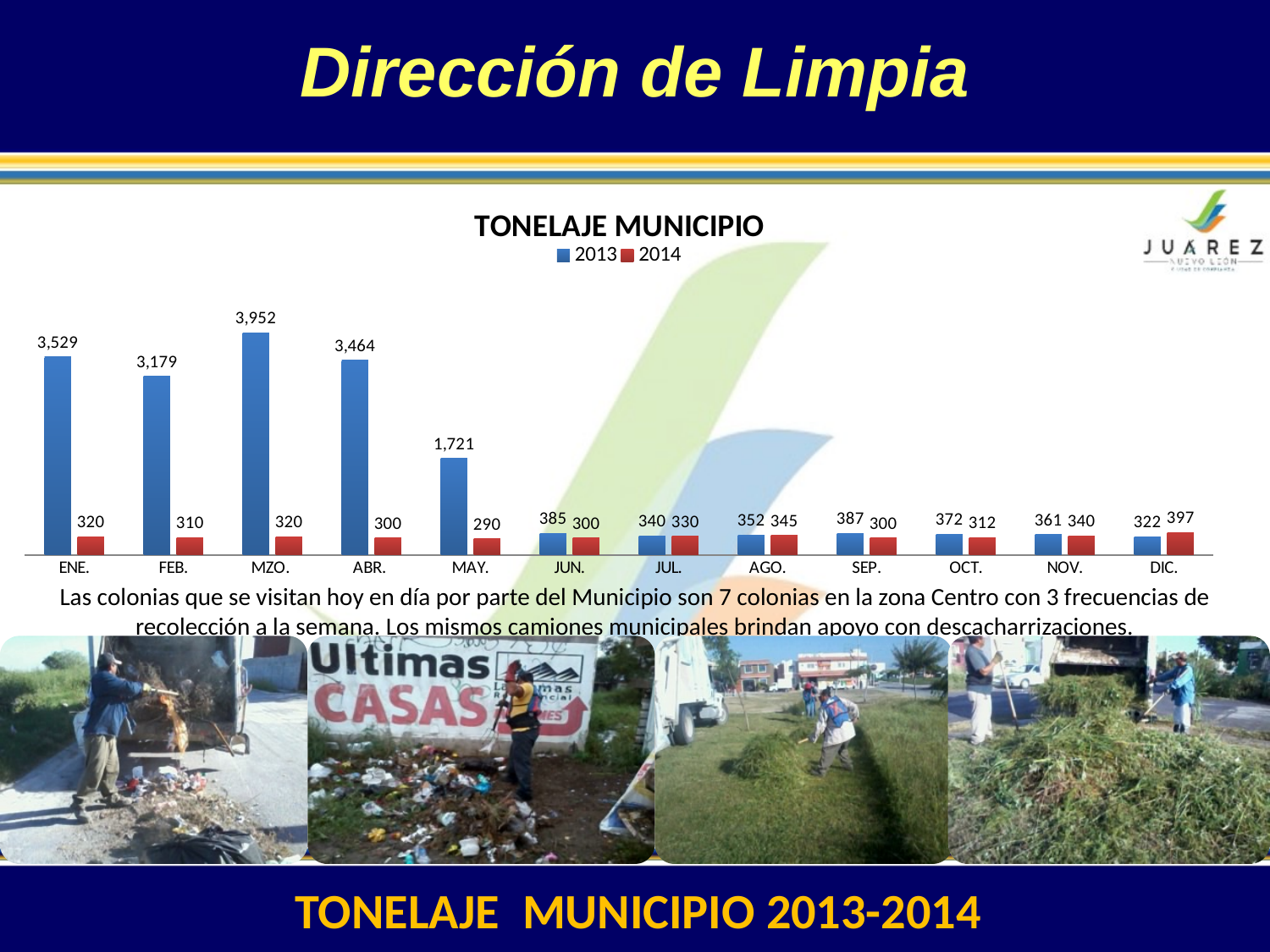
What is the difference between the 2013 and 2014 values for ENE. in the TONELAJE MUNICIPIO chart? 3,209 Which colour represents the 2014 series in the TONELAJE MUNICIPIO chart? Red How many series does the legend of the TONELAJE MUNICIPIO chart list? 2 How many months are shown on the x axis of the TONELAJE MUNICIPIO chart? 12 Which month has the highest 2013 value in the TONELAJE MUNICIPIO chart? MZO. What is the 2014 value for DIC. in the TONELAJE MUNICIPIO chart? 397 In the TONELAJE MUNICIPIO chart, which is larger for DIC., the 2013 value or the 2014 value? 2014 What is the 2013 value for MAY. in the TONELAJE MUNICIPIO chart? 1,721 Do the 2013 values in the TONELAJE MUNICIPIO chart rise or fall from ABR. to JUN.? Fall Which month has the lowest 2014 value in the TONELAJE MUNICIPIO chart? MAY. What kind of chart is the TONELAJE MUNICIPIO chart? Bar chart What is the 2013 value for MZO. in the TONELAJE MUNICIPIO chart? 3,952